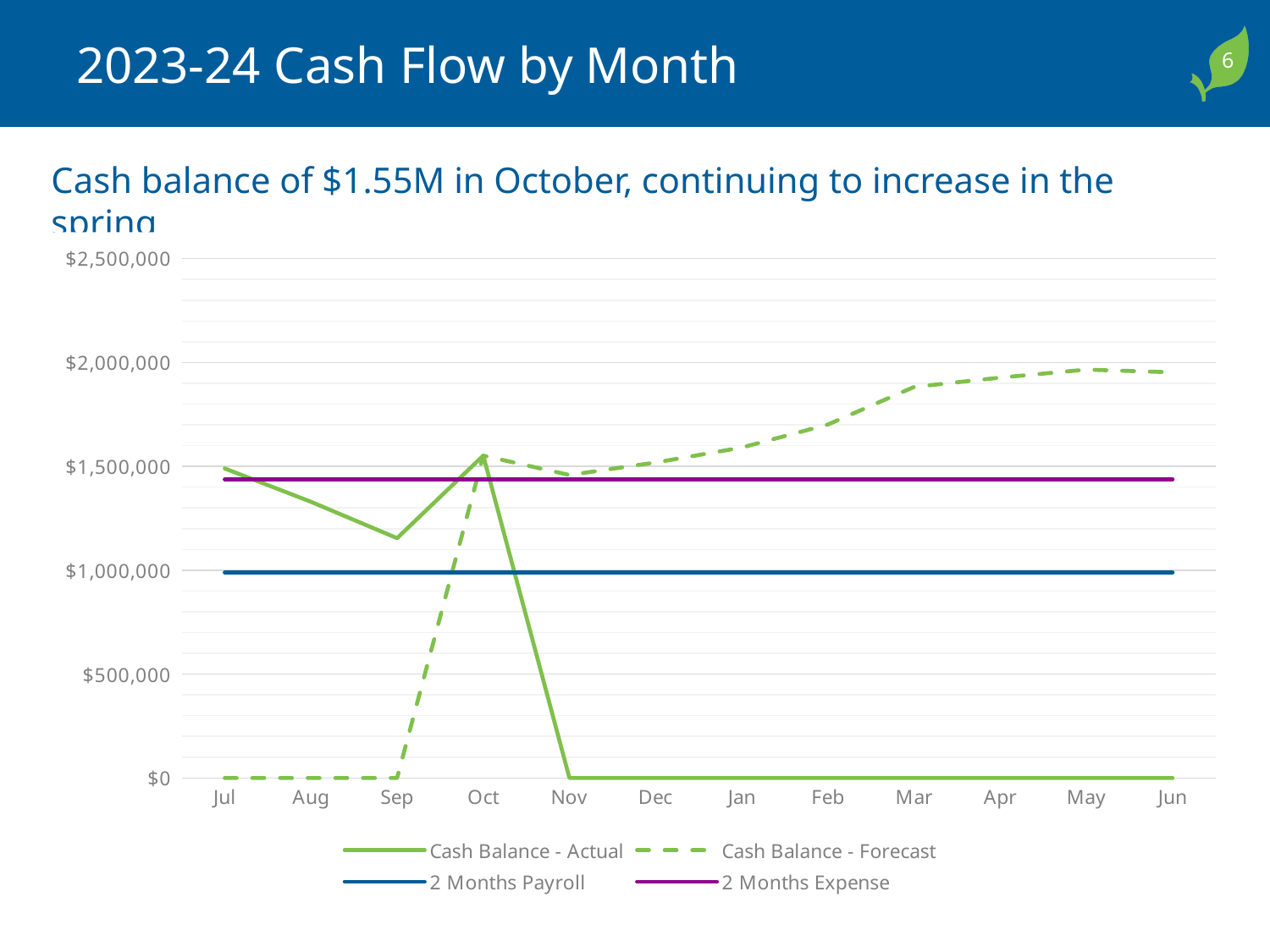
In which month does Cash Balance - Actual reach its highest value? Oct Which is higher, the 2 Months Expense line or the 2 Months Payroll line? 2 Months Expense Does the Cash Balance - Forecast line rise or fall from Nov to May? Rise Is the Cash Balance - Forecast value for Mar greater or less than $1,500,000? greater According to the slide text, what is the cash balance in October? $1.55M Is the Cash Balance - Forecast value for Jun greater or less than $2,000,000? less Is the Cash Balance - Actual value for Oct greater or less than $1,500,000? greater How many series does the legend list? 4 How many months are shown along the x axis? 12 What kind of chart is shown on the slide? Line chart